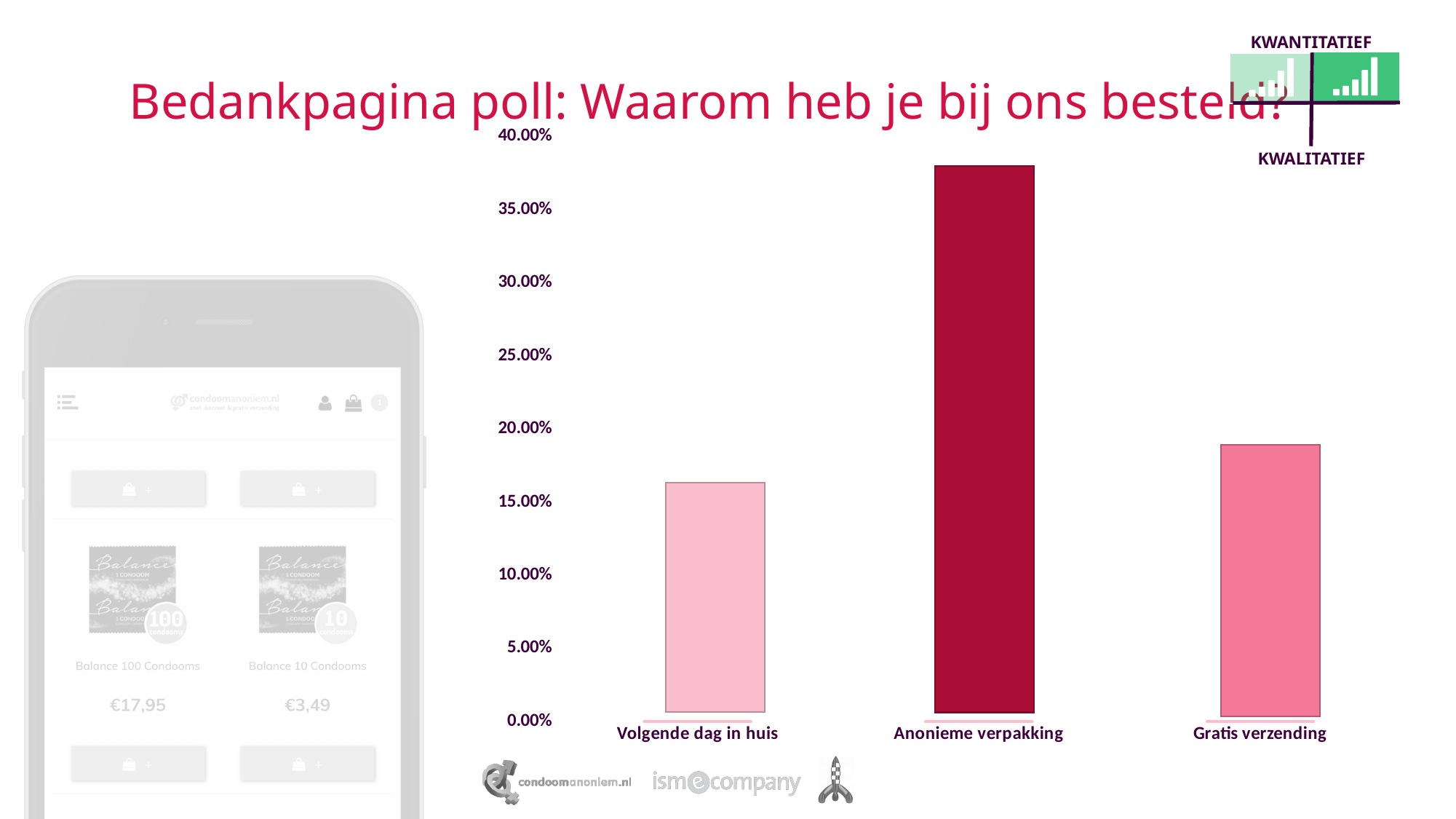
Which category has the highest value in the chart? Anonieme verpakking What kind of chart is shown on the slide? bar chart Which is larger, the value for Gratis verzending or the value for Volgende dag in huis? Gratis verzending Is the value for Gratis verzending greater or less than 15.00%? greater What is the title of the slide containing the chart? Bedankpagina poll: Waarom heb je bij ons besteld? Is the value for Anonieme verpakking greater or less than 35.00%? greater What is the highest value shown on the chart's vertical axis? 40.00% Is the value for Volgende dag in huis greater or less than 20.00%? less Which is larger, the value for Anonieme verpakking or the value for Gratis verzending? Anonieme verpakking How many categories are plotted in the chart? 3 Which category has the lowest value in the chart? Volgende dag in huis